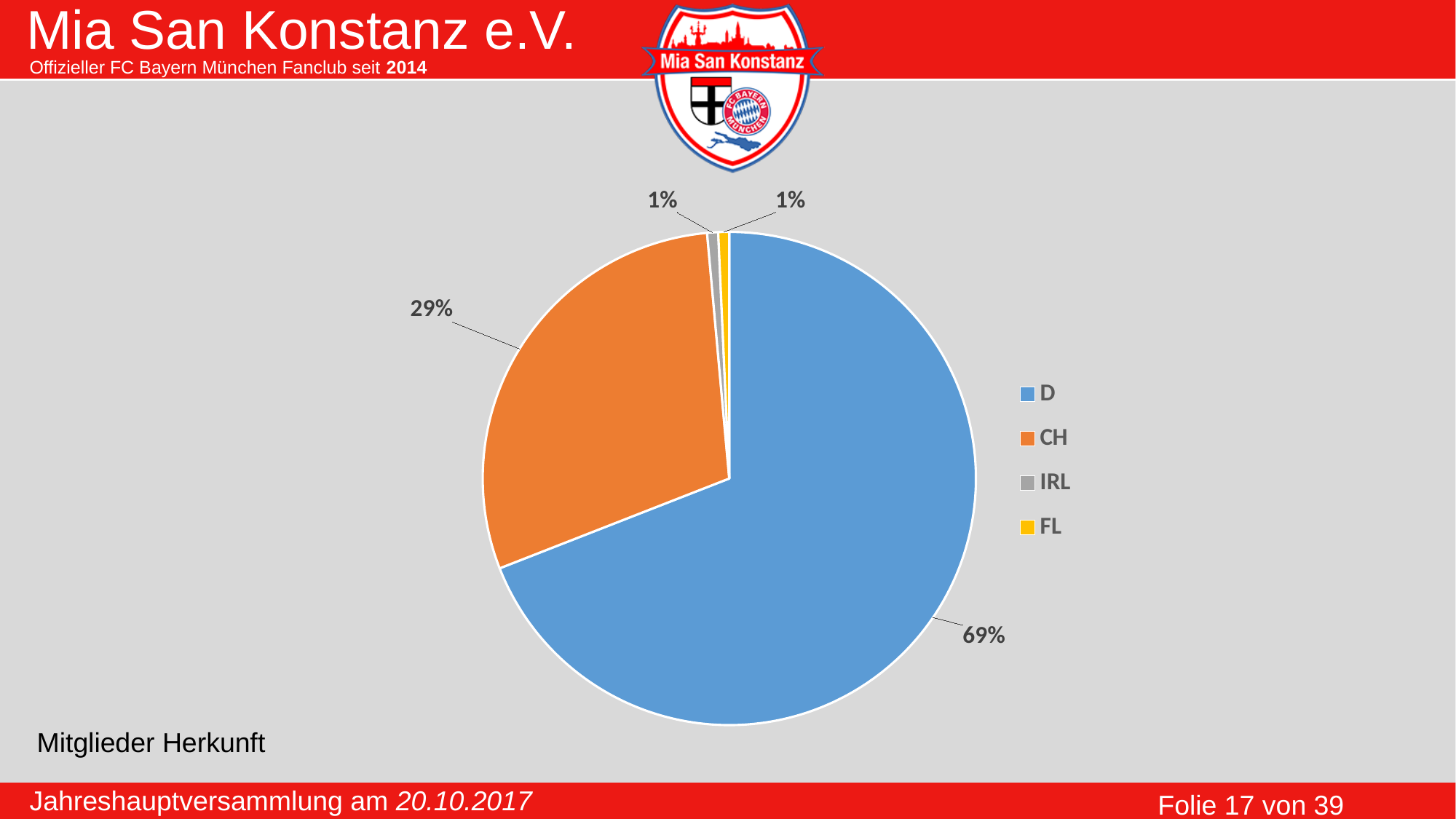
How many categories does the legend list? 4 What share of the pie does CH have? 29% What share of the pie does IRL have? 1% What is the difference in percentage points between the D slice and the CH slice? 40 What share of the pie does D have? 69% Which is larger, the slice for CH or the slice for IRL? CH What kind of chart is shown on the slide? pie chart What is the combined share of D and CH? 98% What colour is the slice for CH? orange What is the caption text below the chart? Mitglieder Herkunft Which category has the largest slice of the pie? D